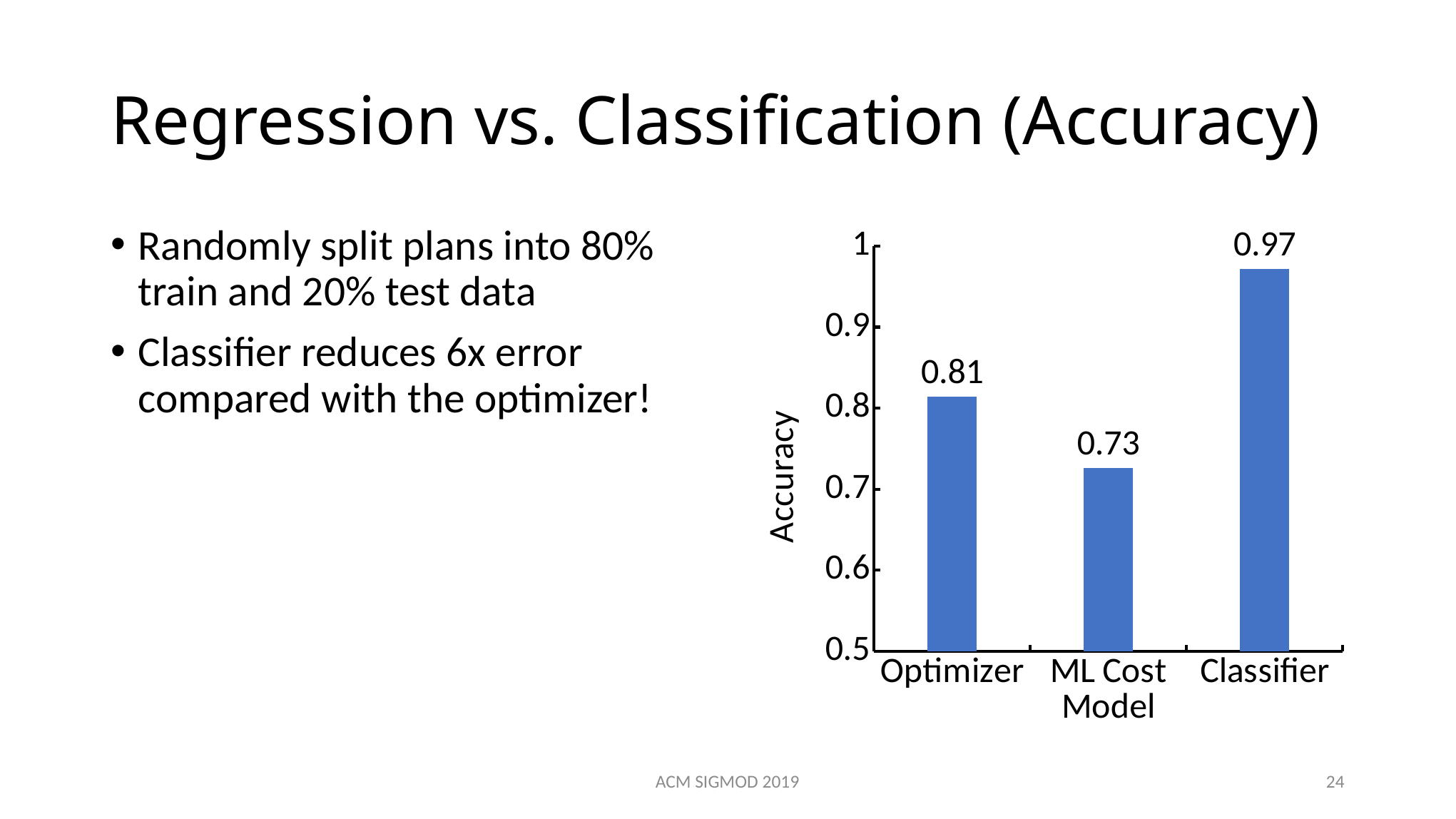
What is the difference in accuracy between Optimizer and ML Cost Model? 0.08 Which has a higher accuracy, Optimizer or ML Cost Model? Optimizer What is the accuracy value for Optimizer? 0.81 Which category has the highest accuracy? Classifier Is the accuracy for Classifier greater or less than 0.9? greater What is the accuracy value for Classifier? 0.97 What kind of chart is shown on the slide? bar chart What is the accuracy value for ML Cost Model? 0.73 How many categories are shown on the x axis of the chart? 3 What is the difference in accuracy between Classifier and Optimizer? 0.16 Which category has the lowest accuracy? ML Cost Model What is the label of the vertical axis of the chart? Accuracy